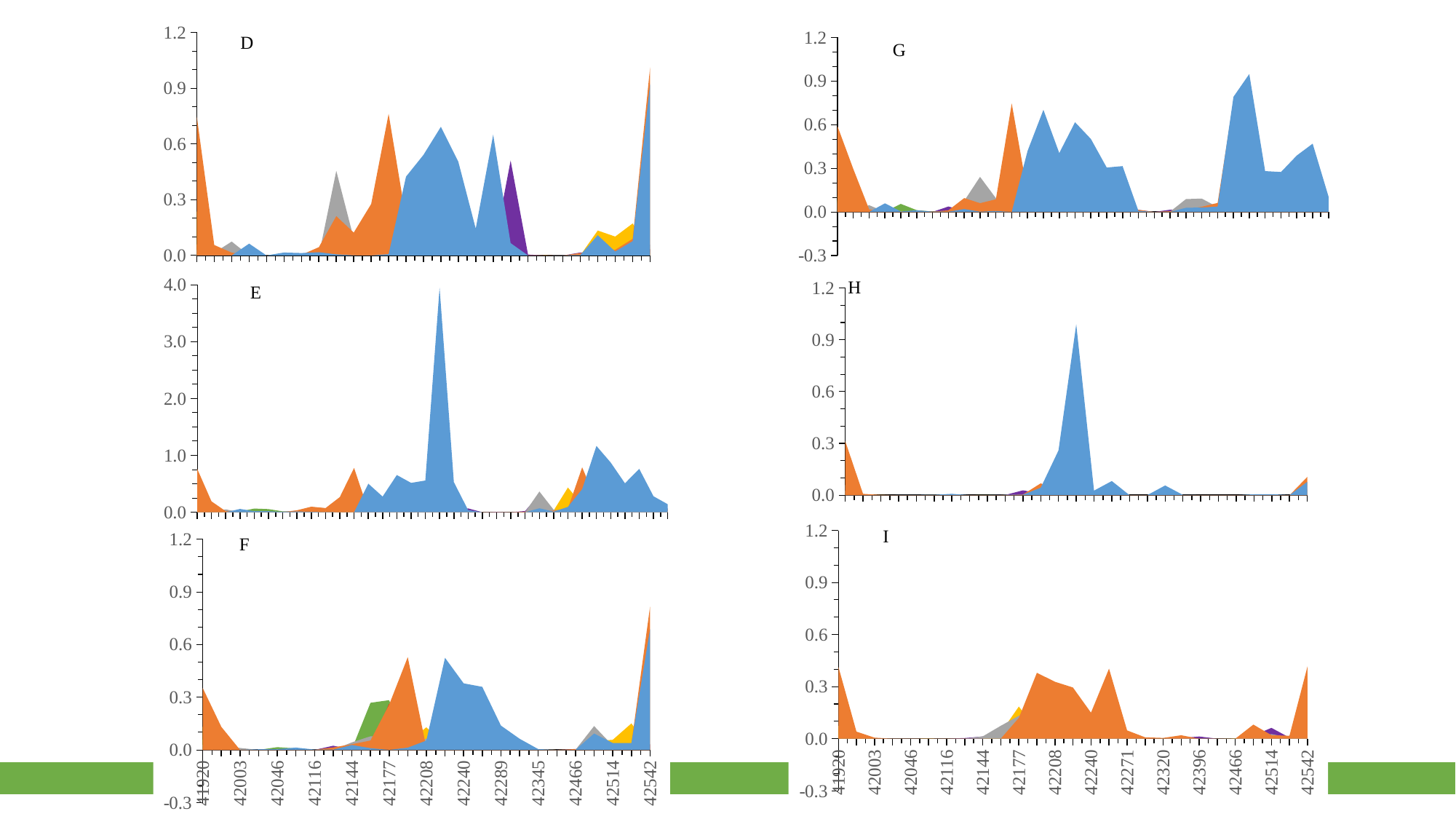
In chart F, is the value at the last x-axis label 42542 greater or less than 0.6? greater Which chart has a y-axis that goes up to 4.0? E In chart H, is the tallest blue peak greater or less than 0.6? greater In chart D, is the value at the far right end greater or less than 0.9? greater In chart H, which is larger: the value at the far left or the peak near 42240? the peak near 42240 What is the first x-axis label shown on chart F? 41920 What kind of chart is chart D? area chart In chart E, which is larger: the peak near 42208 or the peak near 42514? the peak near 42208 How many charts are on the slide? 6